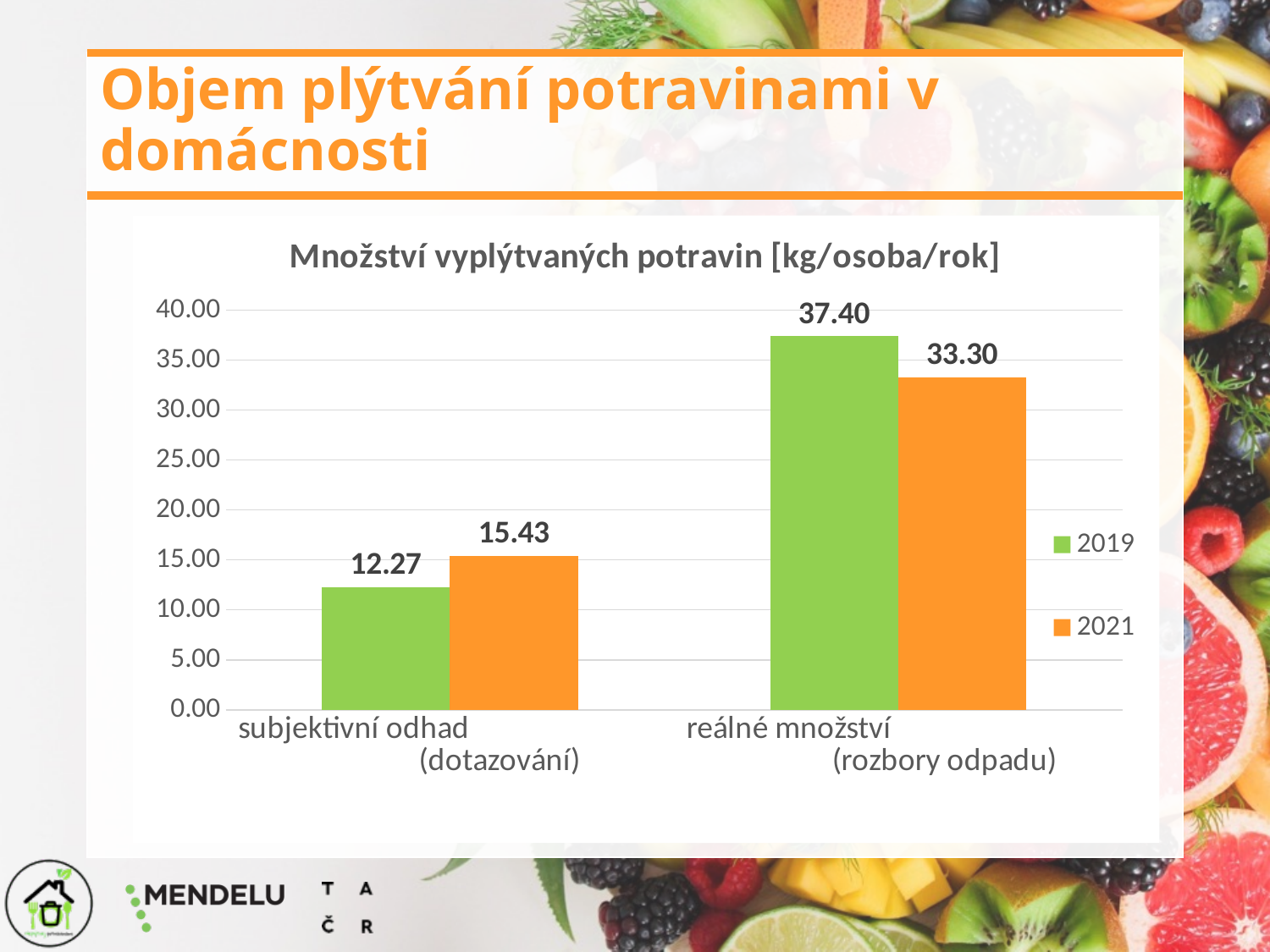
What is the 2019 value for 'reálné množství (rozbory odpadu)'? 37.40 What is the 2019 value for 'subjektivní odhad (dotazování)'? 12.27 What is the difference between the 2021 and 2019 values for 'subjektivní odhad (dotazování)'? 3.16 Which is larger for 'reálné množství (rozbory odpadu)': the 2019 value or the 2021 value? 2019 Which category has the lowest 2021 value? subjektivní odhad (dotazování) What is the difference between the 2019 and 2021 values for 'reálné množství (rozbory odpadu)'? 4.10 What kind of chart is shown on the slide? bar chart Is the 2021 value for 'subjektivní odhad (dotazování)' greater or less than 20.00? less How many categories are shown on the x axis? 2 How many series does the legend list? 2 Which category has the highest 2019 value? reálné množství (rozbory odpadu) What is the 2021 value for 'reálné množství (rozbory odpadu)'? 33.30